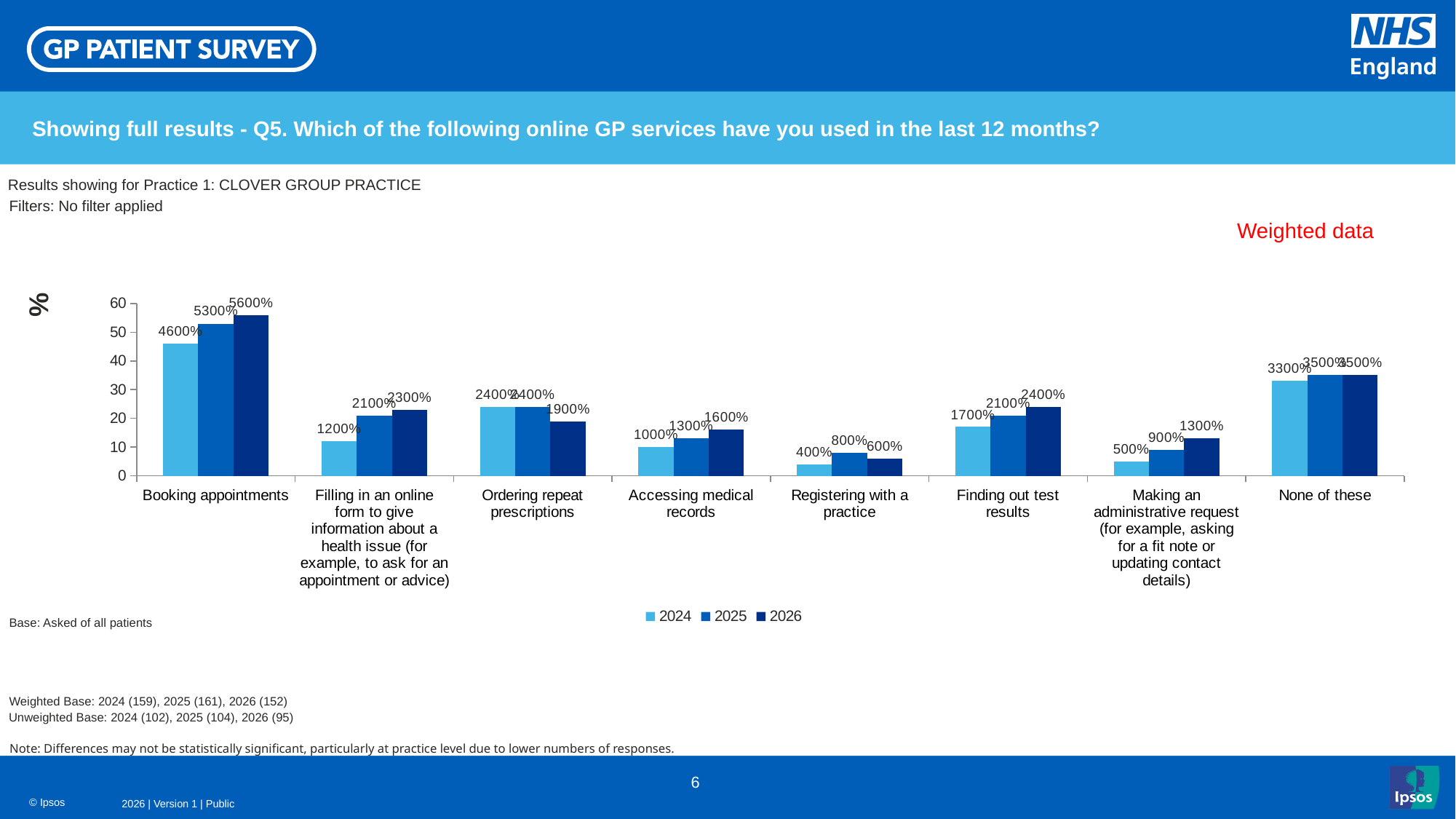
What is the data label for Making an administrative request in 2025? 900% What type of chart is shown on the slide? bar chart What is the data label for Accessing medical records in 2024? 1000% What is the data label for Booking appointments in 2026? 5600% How many categories are shown on the x axis? 8 Which category has the highest value for 2024? Booking appointments Which category has the lowest value for 2026? Registering with a practice Do the values for Booking appointments rise or fall from 2024 to 2026? rise How many series does the legend list? 3 Is the 2025 bar for None of these above or below the 30 gridline on the axis? above Which is larger for Finding out test results: the 2024 value or the 2026 value? 2026 Which series is shown in the darkest blue in the legend? 2026